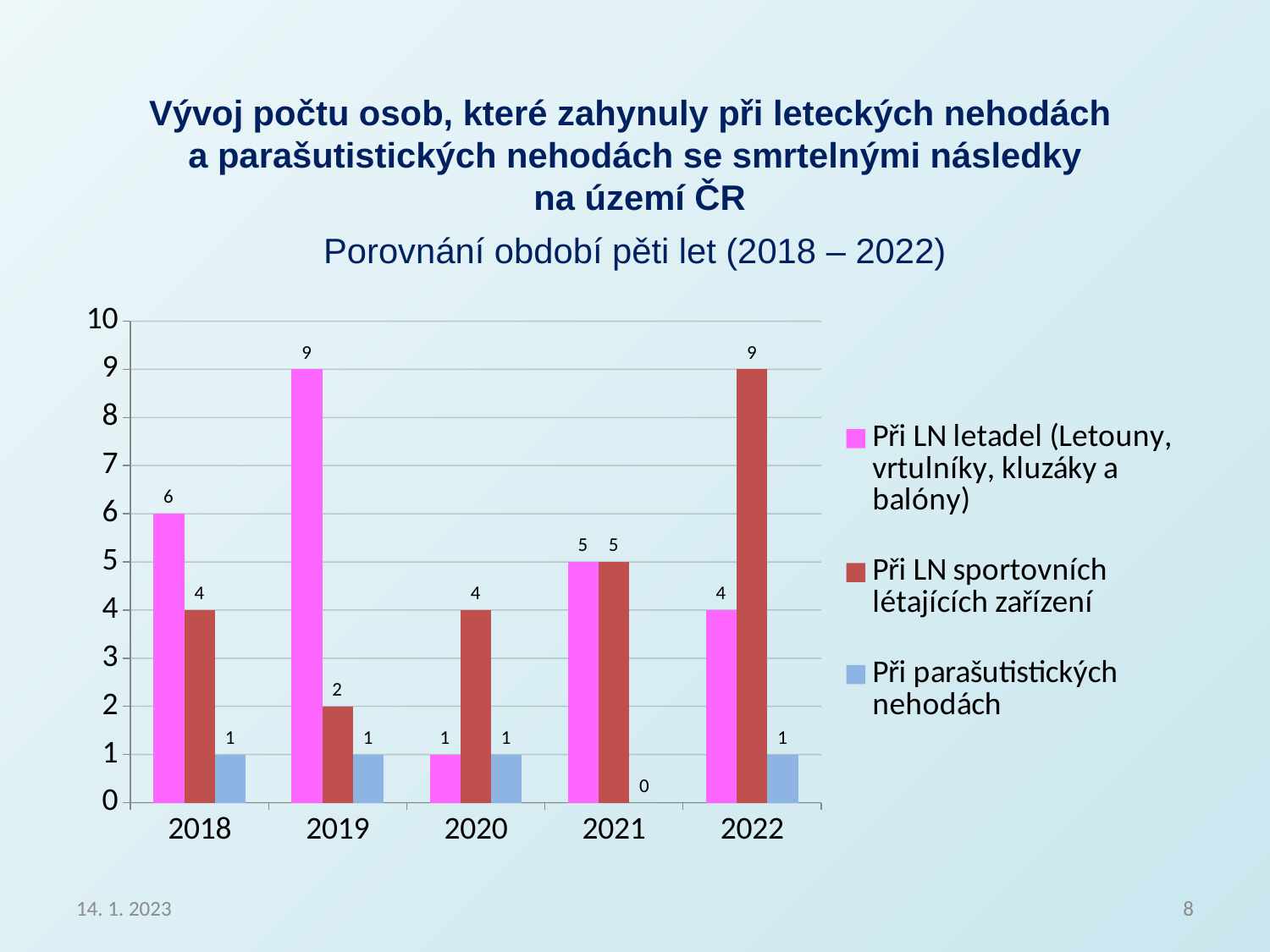
What is the value for "Při LN sportovních létajících zařízení" in 2022? 9 What is the value for "Při LN sportovních létajících zařízení" in 2019? 2 What kind of chart is shown on the slide? Bar chart What is the value for "Při parašutistických nehodách" in 2021? 0 What is the difference between the "Při LN letadel" value and the "Při LN sportovních létajících zařízení" value in 2018? 2 In which year is the value for "Při LN letadel (Letouny, vrtulníky, kluzáky a balóny)" highest? 2019 What colour are the bars for "Při parašutistických nehodách"? Light blue In which year is the value for "Při LN letadel (Letouny, vrtulníky, kluzáky a balóny)" lowest? 2020 How many series does the legend list? 3 How many years are shown on the x axis? 5 What is the value for "Při LN letadel (Letouny, vrtulníky, kluzáky a balóny)" in 2019? 9 In 2022, which series has the larger value: "Při LN letadel" or "Při LN sportovních létajících zařízení"? Při LN sportovních létajících zařízení